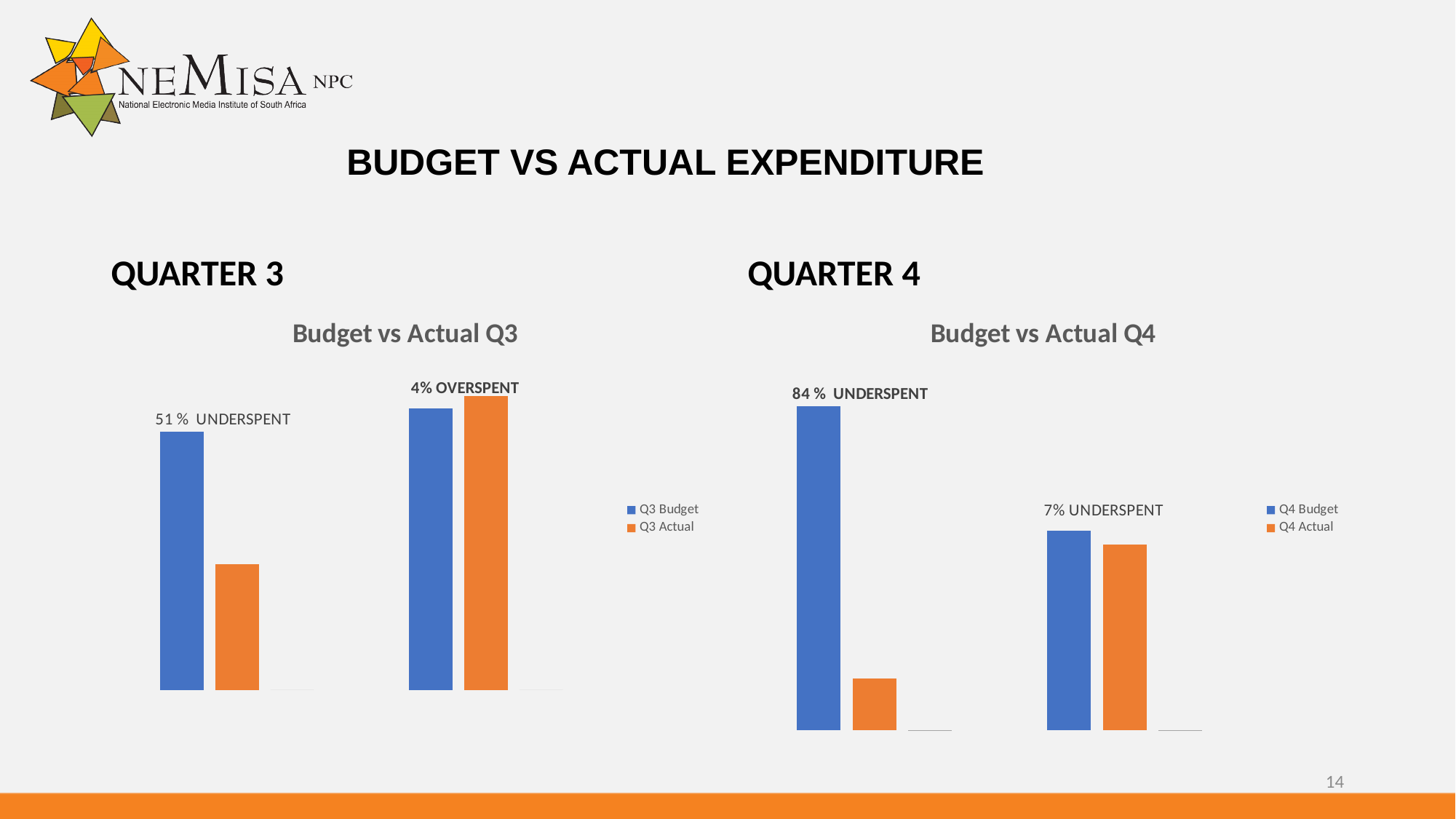
How many series does the legend of the "Budget vs Actual Q4" chart list? 2 How many groups of bars are plotted in the "Budget vs Actual Q3" chart? 2 In the "Budget vs Actual Q3" chart, in the right group of bars, which is larger: Q3 Budget or Q3 Actual? Q3 Actual In the "Budget vs Actual Q4" chart, in the right group of bars, which is larger: Q4 Budget or Q4 Actual? Q4 Budget What colour are the Budget bars in both charts? blue In the "Budget vs Actual Q4" chart, in the left group of bars, which is larger: Q4 Budget or Q4 Actual? Q4 Budget What are the two legend entries of the "Budget vs Actual Q3" chart? Q3 Budget, Q3 Actual In the "Budget vs Actual Q4" chart, which bar is the tallest? Q4 Budget in the left group How many groups of bars are plotted in the "Budget vs Actual Q4" chart? 2 What kind of chart is the "Budget vs Actual Q3" chart? bar chart In the "Budget vs Actual Q4" chart, which bar is the shortest? Q4 Actual in the left group